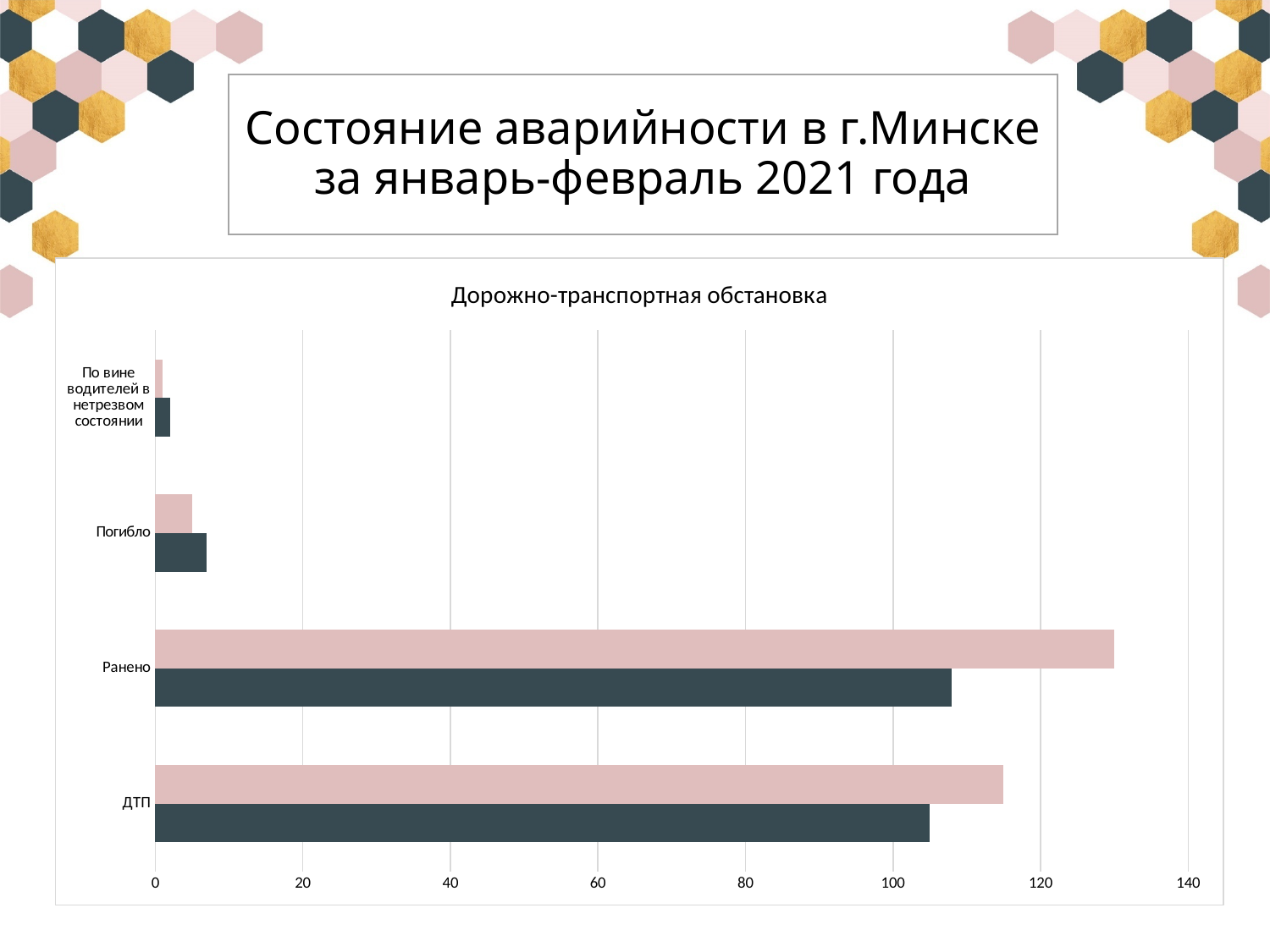
Is the value of the dark bar for Погибло greater or less than 20? less For the category Погибло, which bar is longer, the pink one or the dark one? the dark one For the category Ранено, which bar is longer, the pink one or the dark one? the pink one How many bars are drawn for each category in the chart? 2 What kind of chart is shown on the slide? bar chart Which category has the shortest bars in the chart? По вине водителей в нетрезвом состоянии Is the value of the dark bar for ДТП greater or less than 100? greater Is the value of the pink bar for Ранено greater or less than 120? greater What is the title of the chart? Дорожно-транспортная обстановка Which category has the longest bar in the chart? Ранено How many categories are shown on the vertical axis of the chart? 4